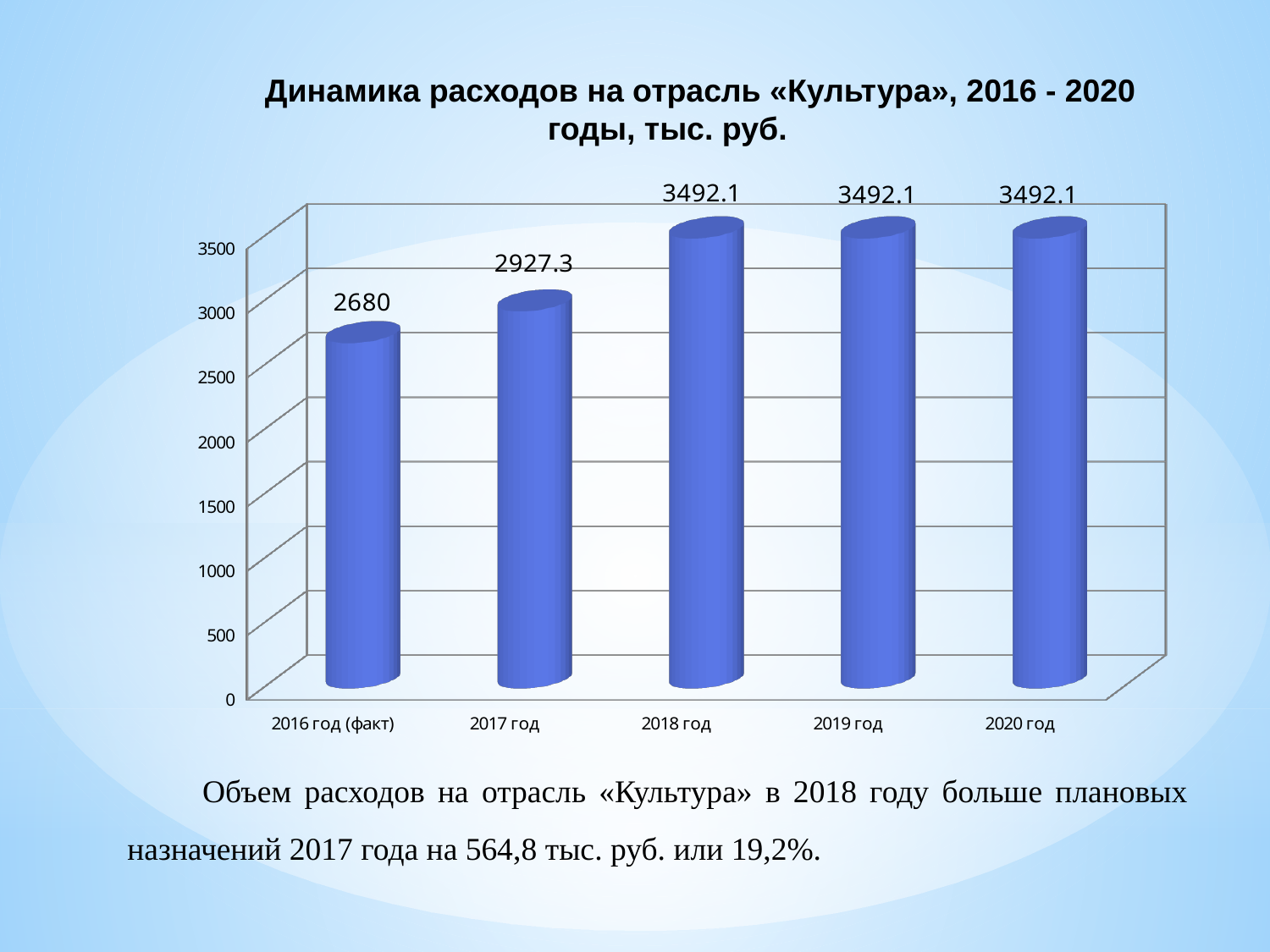
How many categories are shown on the x axis? 5 What is the difference between the values for 2018 год and 2017 год? 564.8 Is the value for 2016 год (факт) greater or less than 3000? less What is the value for 2017 год? 2927.3 Which is larger, the value for 2017 год or the value for 2016 год (факт)? 2017 год What is the title of the chart? Динамика расходов на отрасль «Культура», 2016 - 2020 годы, тыс. руб. What is the value for 2019 год? 3492.1 What kind of chart is shown on the slide? bar chart Which category has the lowest value? 2016 год (факт) What is the value for 2016 год (факт)? 2680 What is the difference between the values for 2017 год and 2016 год (факт)? 247.3 Do the values rise or fall from 2016 год (факт) to 2018 год? rise